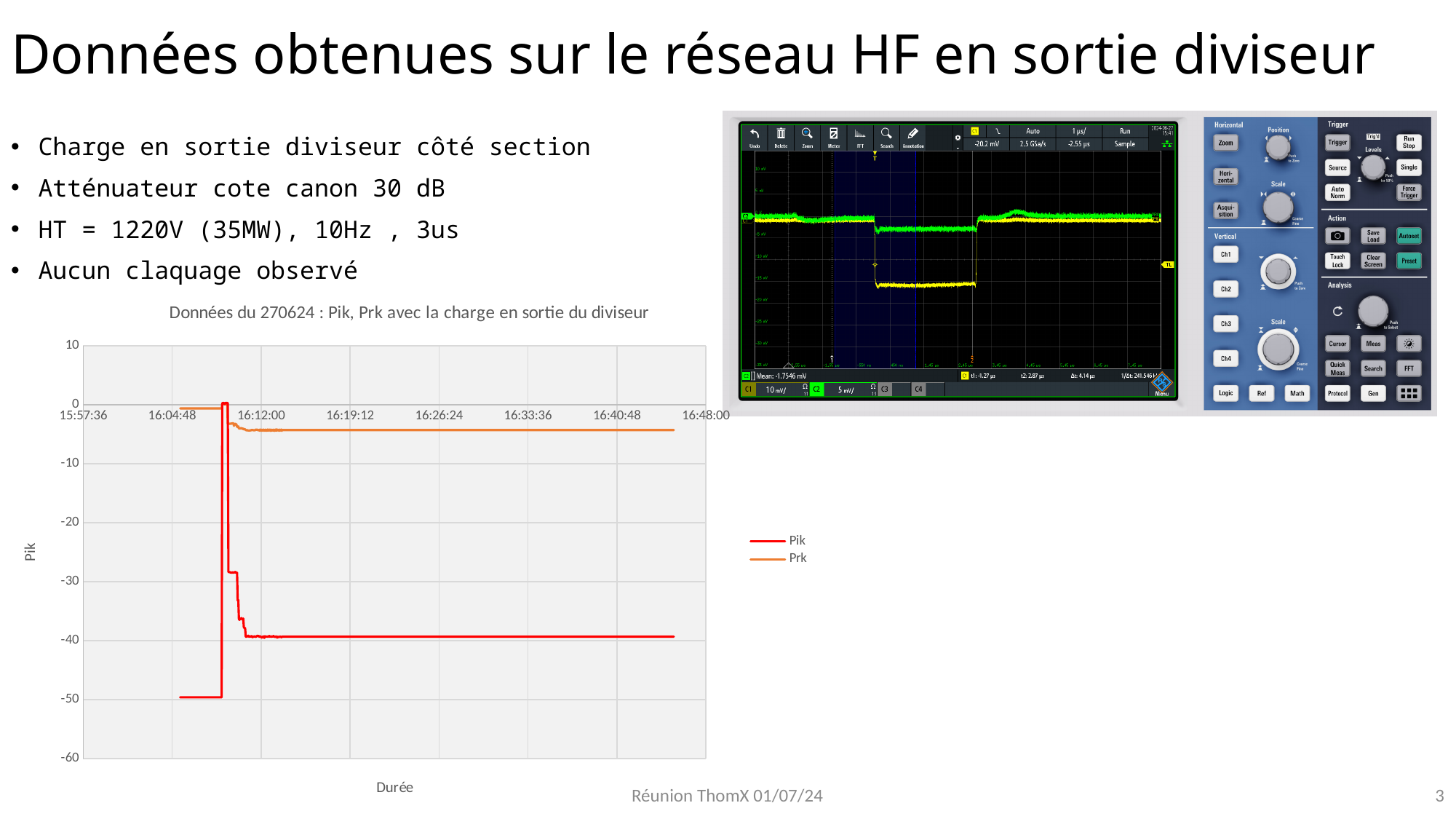
Is the value of Pik at 16:40:48 greater or less than -50? greater What kind of chart is shown on the slide? line chart Is the value of Pik at 16:04:48 greater or less than -40? less What are the two series named in the chart legend? Pik and Prk At 16:26:24, which series has the higher value, Pik or Prk? Prk Does the Prk series rise, fall or stay flat between 16:19:12 and 16:48:00? stays flat How many series does the legend of the chart list? 2 Does the Pik series rise, fall or stay flat between 16:19:12 and 16:48:00? stays flat Is the value of Pik at 16:40:48 greater or less than -30? less What is the label of the x axis of the chart? Durée